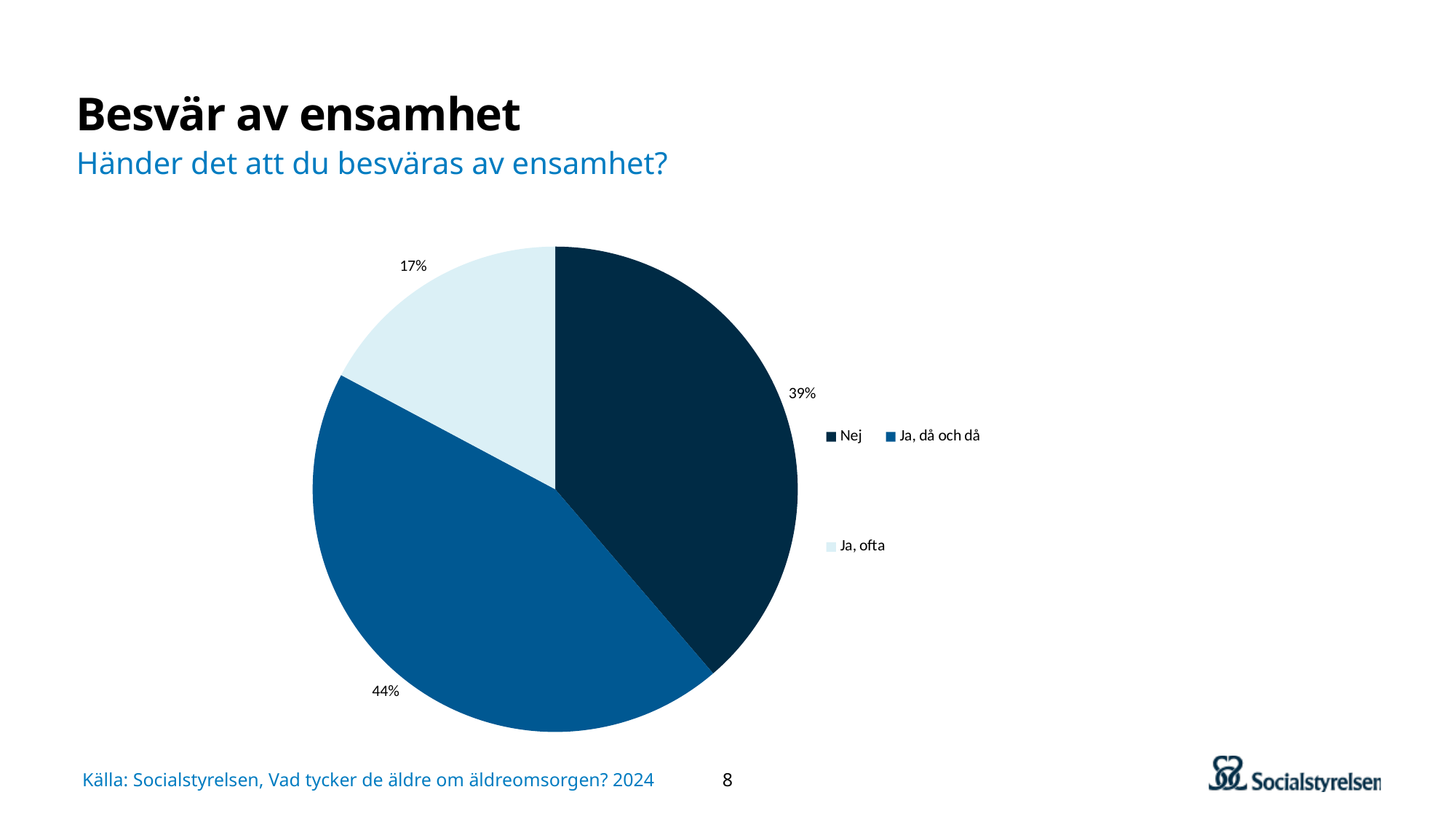
How many entries does the legend list? 3 What share of the pie is labelled "Nej"? 39% Which category has the largest slice of the pie? Ja, då och då What question is shown as the subtitle above the chart? Händer det att du besväras av ensamhet? What is the difference in percentage points between "Ja, då och då" and "Nej"? 5 percentage points Which category has the smallest slice of the pie? Ja, ofta What share of the pie is labelled "Ja, ofta"? 17% What kind of chart is shown on the slide? pie chart What is the difference in percentage points between "Nej" and "Ja, ofta"? 22 percentage points Which is larger, the slice for "Nej" or the slice for "Ja, ofta"? Nej How many slices does the pie chart have? 3 What share of the pie is labelled "Ja, då och då"? 44%